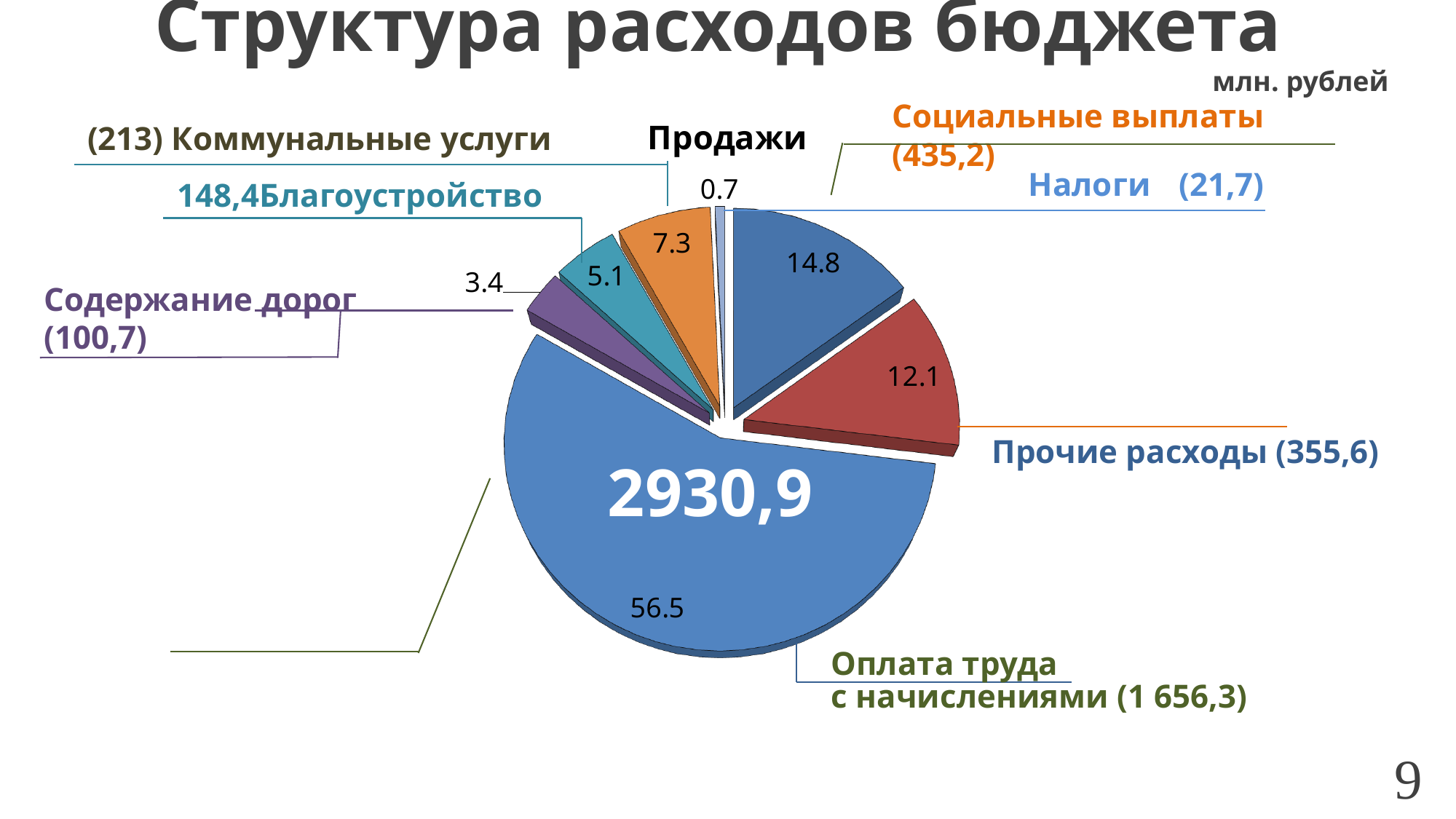
What is the title of the chart on the slide? Продажи What percentage share is printed on the largest slice of the pie? 56.5 What is the value shown for Прочие расходы? 355,6 What is the value shown for Содержание дорог? 100,7 Which category has the largest slice of the pie? Оплата труда с начислениями In what units are the values on the slide given? млн. рублей What total value is printed in the centre of the pie chart? 2930,9 What is the value shown for Оплата труда с начислениями? 1 656,3 What kind of chart is shown on the slide? pie chart Which is larger, Социальные выплаты or Прочие расходы? Социальные выплаты How many slices does the pie chart have? 7 What is the value shown for Социальные выплаты? 435,2